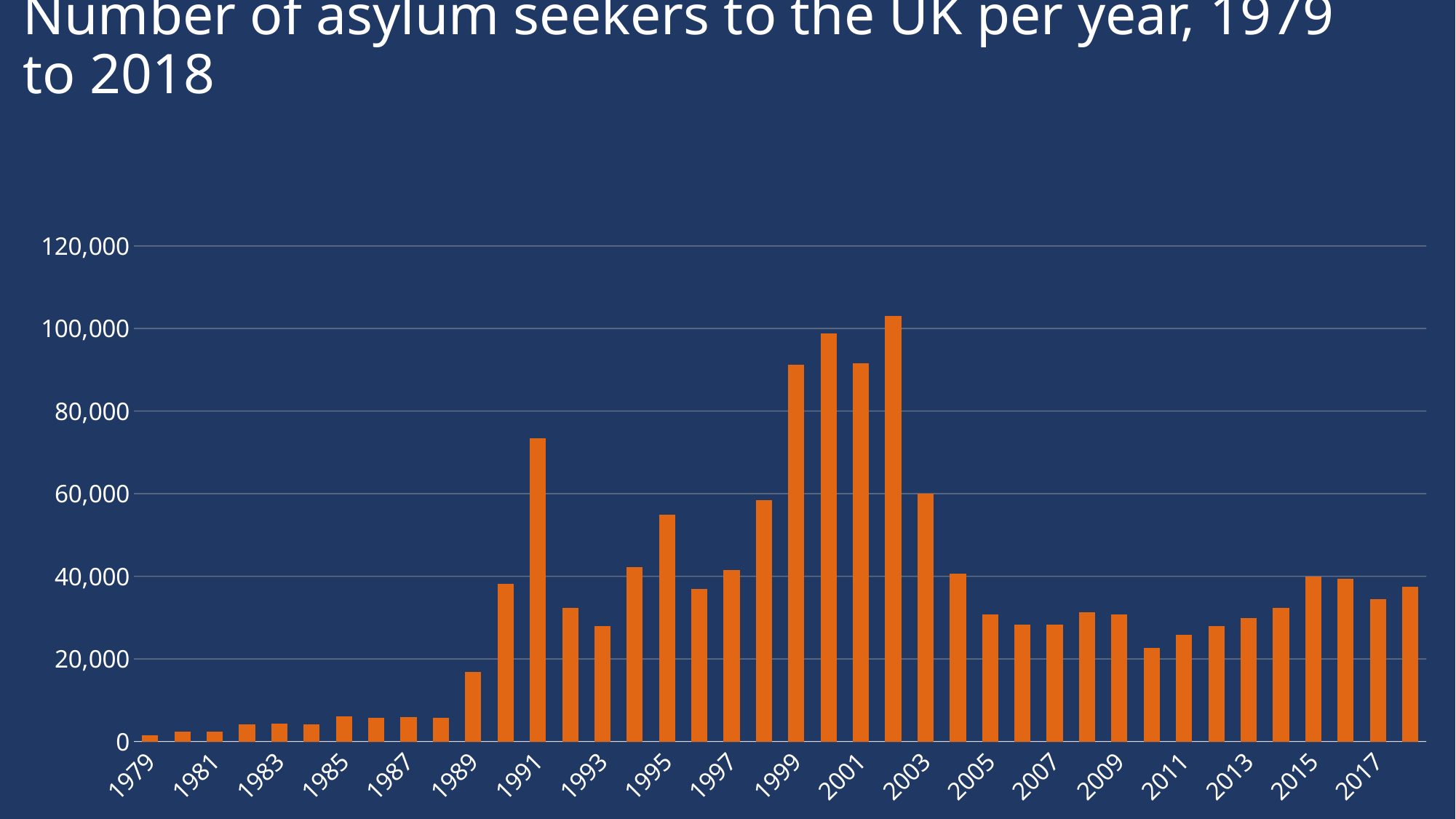
Is the value for 1995 greater or less than 60,000? less What kind of chart is shown on the slide? bar chart Is the value for 2017 greater or less than 40,000? less Which year has the larger value, 1991 or 1995? 1991 What is the title of the chart? Number of asylum seekers to the UK per year, 1979 to 2018 Which year has the lowest number of asylum seekers? 1979 Is the value for 1991 greater or less than 60,000? greater Which year has the larger value, 2007 or 2017? 2017 Do the values generally rise or fall from 2003 to 2007? fall Do the values generally rise or fall from 1979 to 1991? rise